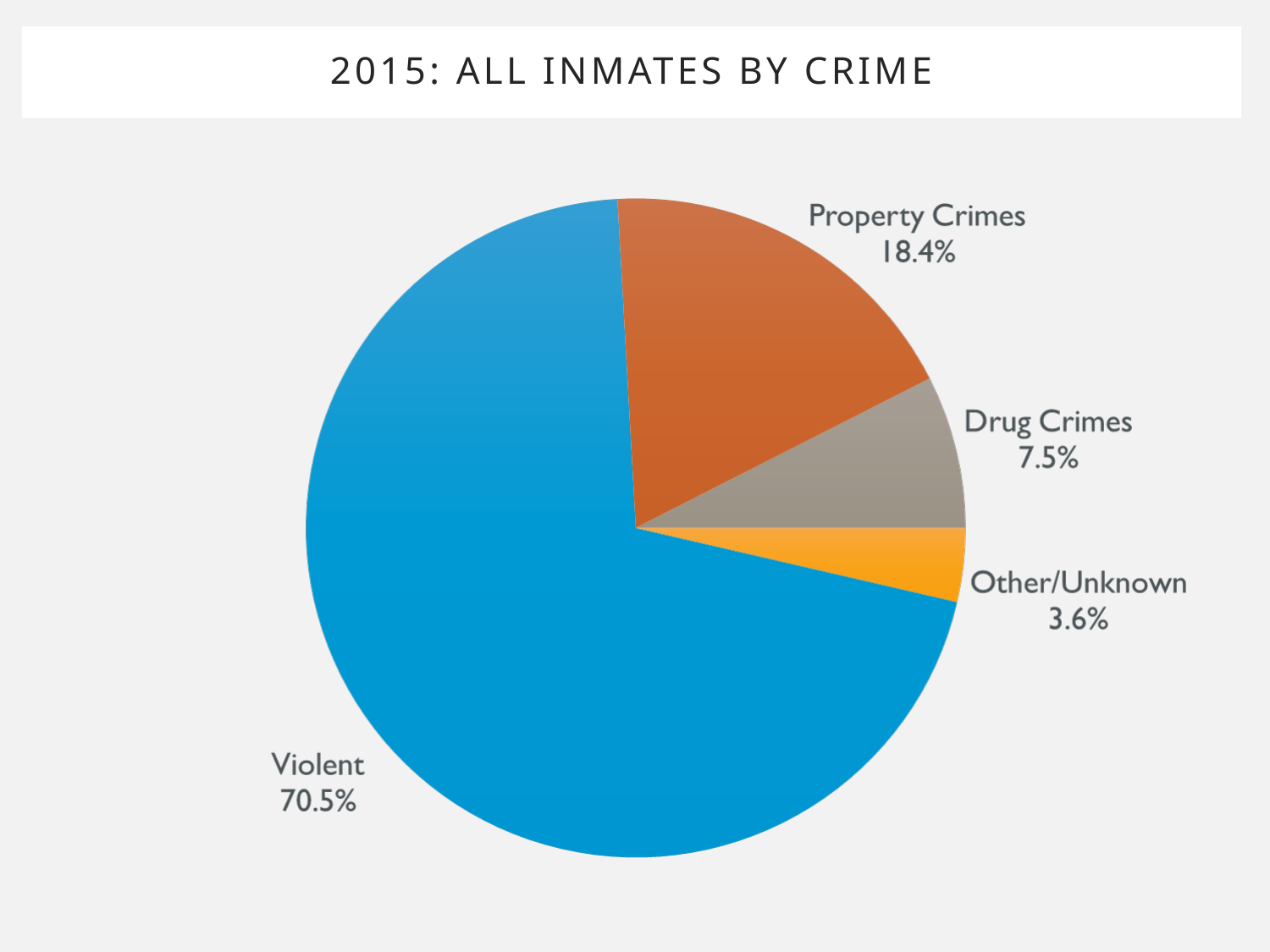
Which category has the largest slice of the pie? Violent How many categories are shown in the pie chart? 4 What share of inmates is shown for Violent crimes? 70.5% Which category has the smallest slice of the pie? Other/Unknown What colour is the Violent slice of the pie? blue What share of inmates is shown for Drug Crimes? 7.5% What is the difference in percentage points between Property Crimes and Drug Crimes? 10.9 What is the title of the chart? 2015: ALL INMATES BY CRIME Which is larger, the share for Drug Crimes or the share for Other/Unknown? Drug Crimes What share of inmates is shown for Property Crimes? 18.4% What share of inmates is shown for Other/Unknown? 3.6% What type of chart is shown on the slide? pie chart